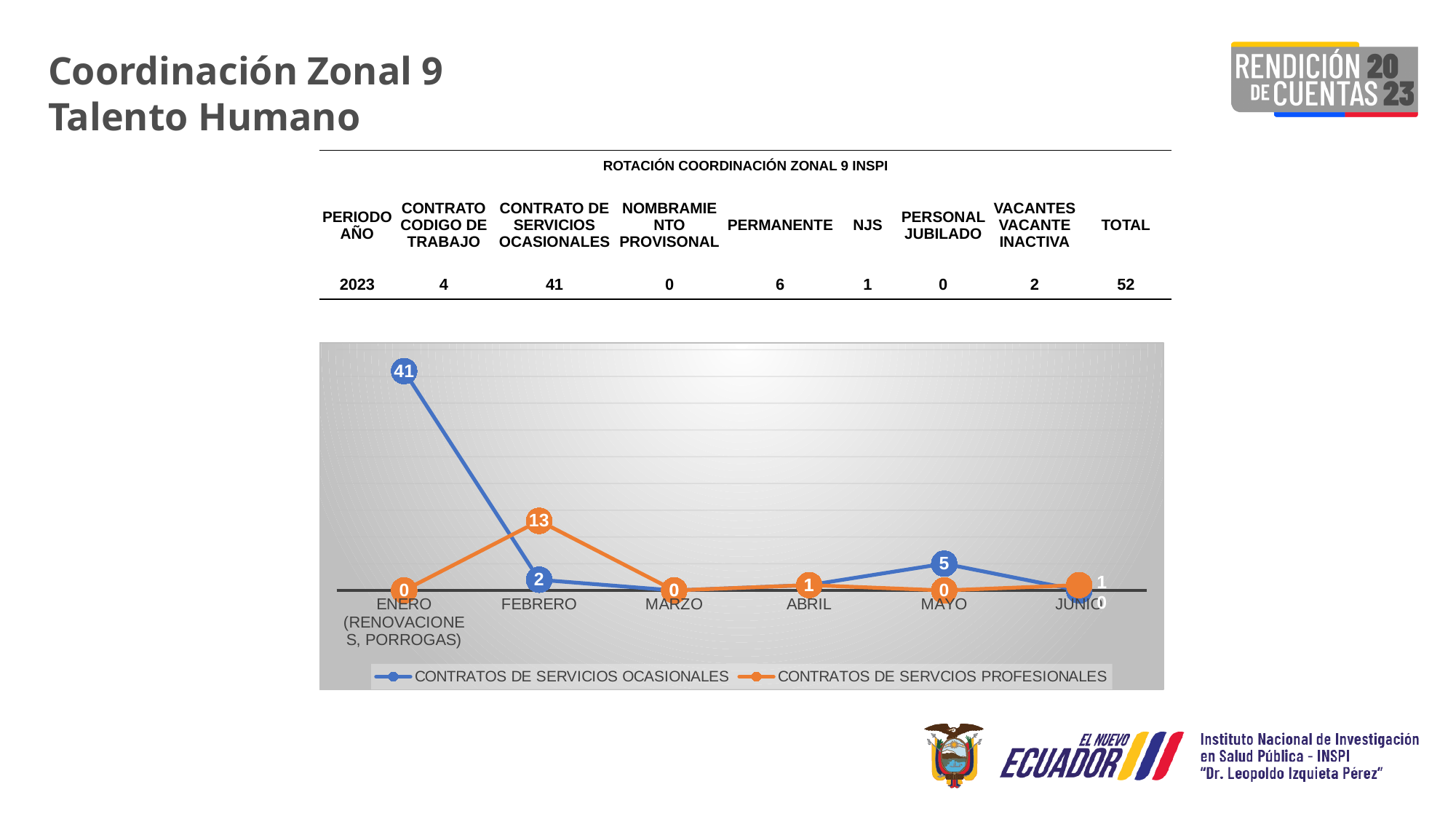
What is the value for CONTRATOS DE SERVICIOS OCASIONALES in ENERO (RENOVACIONES, PORROGAS)? 41 In FEBRERO, which series has the larger value: CONTRATOS DE SERVICIOS OCASIONALES or CONTRATOS DE SERVCIOS PROFESIONALES? CONTRATOS DE SERVCIOS PROFESIONALES How many series does the chart legend list? 2 What is the value for CONTRATOS DE SERVCIOS PROFESIONALES in FEBRERO? 13 What is the value for CONTRATOS DE SERVICIOS OCASIONALES in MAYO? 5 What is the difference between CONTRATOS DE SERVICIOS OCASIONALES in ENERO and in FEBRERO? 39 How many months are shown on the x axis of the chart? 6 What is the value for CONTRATOS DE SERVICIOS OCASIONALES in FEBRERO? 2 What is the value for CONTRATOS DE SERVCIOS PROFESIONALES in MAYO? 0 What kind of chart is shown on the slide? line chart In which month is CONTRATOS DE SERVICIOS OCASIONALES highest? ENERO (RENOVACIONES, PORROGAS) In which month is CONTRATOS DE SERVCIOS PROFESIONALES highest? FEBRERO